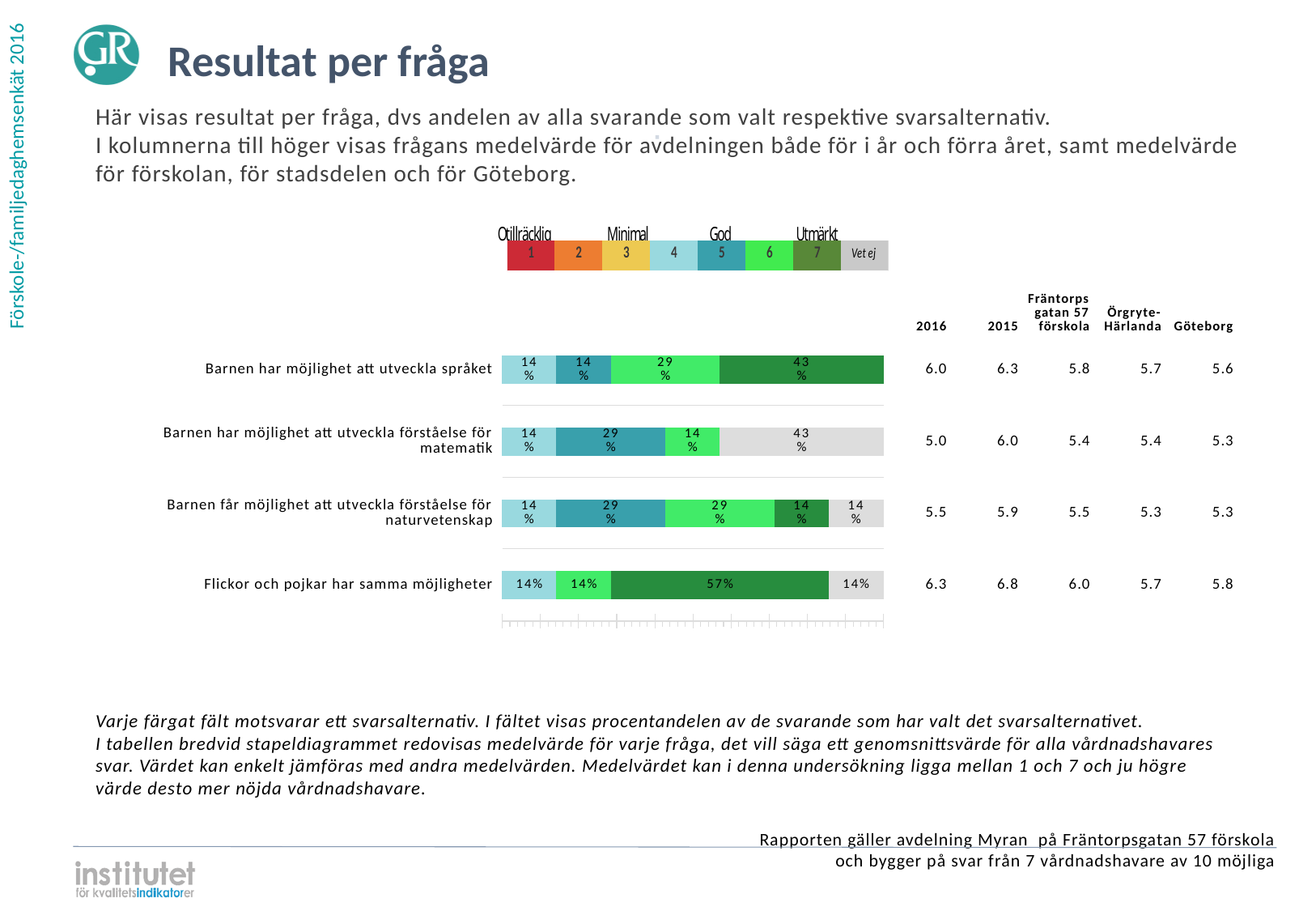
Which question has the lowest 2016 mean value in the table next to the chart? Barnen har möjlighet att utveckla förståelse för matematik (5.0) What is the 2016 mean value shown for 'Flickor och pojkar har samma möjligheter'? 6.3 What percentage of respondents chose option 5 (teal) for 'Barnen får möjlighet att utveckla förståelse för naturvetenskap'? 29% What is the largest segment in the bar for 'Flickor och pojkar har samma möjligheter'? 57% What kind of chart is used to show the results per question? Stacked bar chart What is the difference between the option 7 share (57%) and the option 4 share (14%) for 'Flickor och pojkar har samma möjligheter'? 43 percentage points What percentage of respondents answered 'Vet ej' (grey) for 'Barnen har möjlighet att utveckla förståelse för matematik'? 43% How many questions (categories) are shown as bars in the chart? 4 Which is larger for 'Barnen har möjlighet att utveckla språket': the share for option 6 (bright green) or the share for option 7 (dark green)? Option 7 (43%) What percentage of respondents chose option 7 (dark green) for 'Barnen har möjlighet att utveckla språket'? 43% How many response options does the legend above the chart list, including 'Vet ej'? 8 What label does the legend give to the grey segment at the right end of the bars? Vet ej